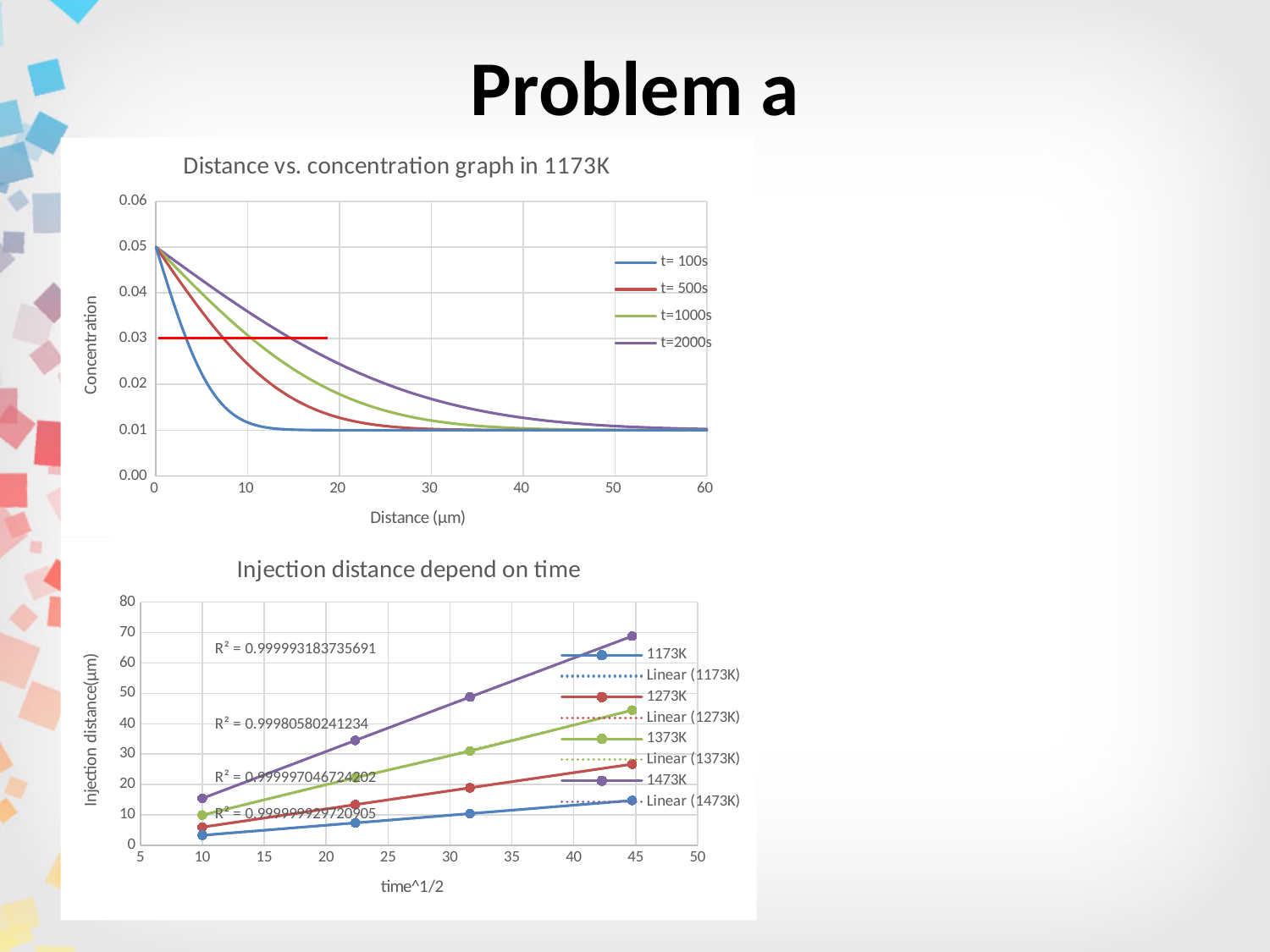
In the top chart 'Distance vs. concentration graph in 1173K', is the concentration for t= 100s at a distance of 10 µm greater or less than 0.02? less In the top chart 'Distance vs. concentration graph in 1173K', which series has the higher concentration at a distance of 20 µm, t= 500s or t=2000s? t=2000s How many series does the legend of the top chart 'Distance vs. concentration graph in 1173K' list? 4 In the bottom chart 'Injection distance depend on time', how many data points are plotted for the 1173K series? 4 In the bottom chart 'Injection distance depend on time', is the injection distance for 1473K at the largest time^1/2 value greater or less than 60? greater In the top chart 'Distance vs. concentration graph in 1173K', do the concentration values rise or fall as distance increases? fall How many entries does the legend of the bottom chart 'Injection distance depend on time' list? 8 What type of chart is the top chart titled 'Distance vs. concentration graph in 1173K'? line chart What is the x-axis label of the bottom chart 'Injection distance depend on time'? time^1/2 In the top chart 'Distance vs. concentration graph in 1173K', is the concentration for t=2000s at a distance of 20 µm greater or less than 0.03? less In the top chart 'Distance vs. concentration graph in 1173K', what concentration do all the curves start at when the distance is 0? 0.05 In the bottom chart 'Injection distance depend on time', which temperature series has the highest injection distance at the largest time^1/2 value? 1473K